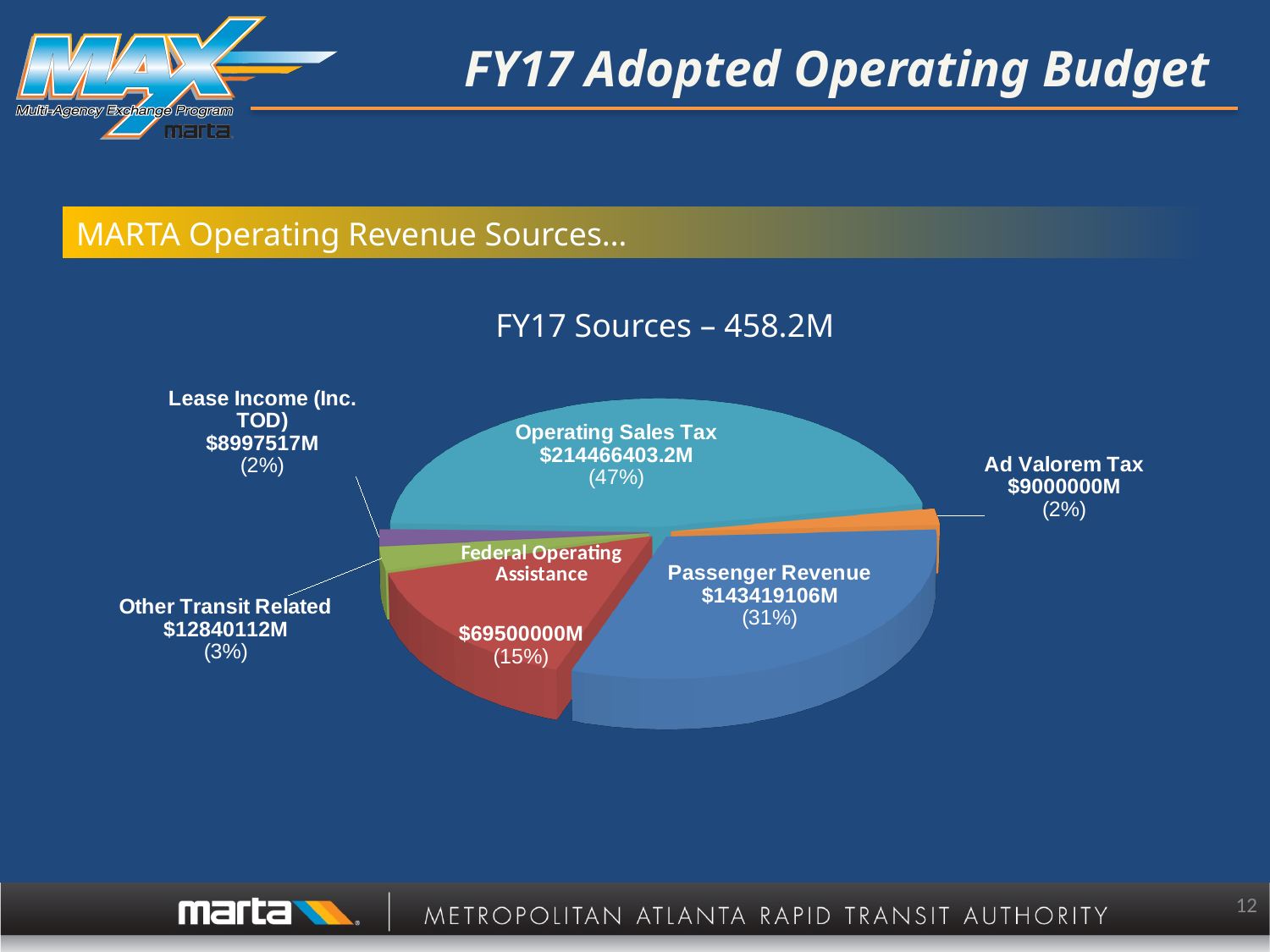
What share of the pie does Lease Income (Inc. TOD) represent? 2% What is the value shown for Passenger Revenue? $143419106M What share of the pie does Passenger Revenue represent? 31% What is the value shown for Ad Valorem Tax? $9000000M How many revenue sources are shown in the pie chart? 6 Which is larger, Passenger Revenue or Federal Operating Assistance? Passenger Revenue What is the value shown for Operating Sales Tax? $214466403.2M What is the value shown for Federal Operating Assistance? $69500000M What is the value shown for Other Transit Related? $12840112M What type of chart is shown on the slide? Pie chart Which revenue source has the largest slice of the pie? Operating Sales Tax By how many percentage points does the Operating Sales Tax share exceed the Passenger Revenue share? 16 percentage points